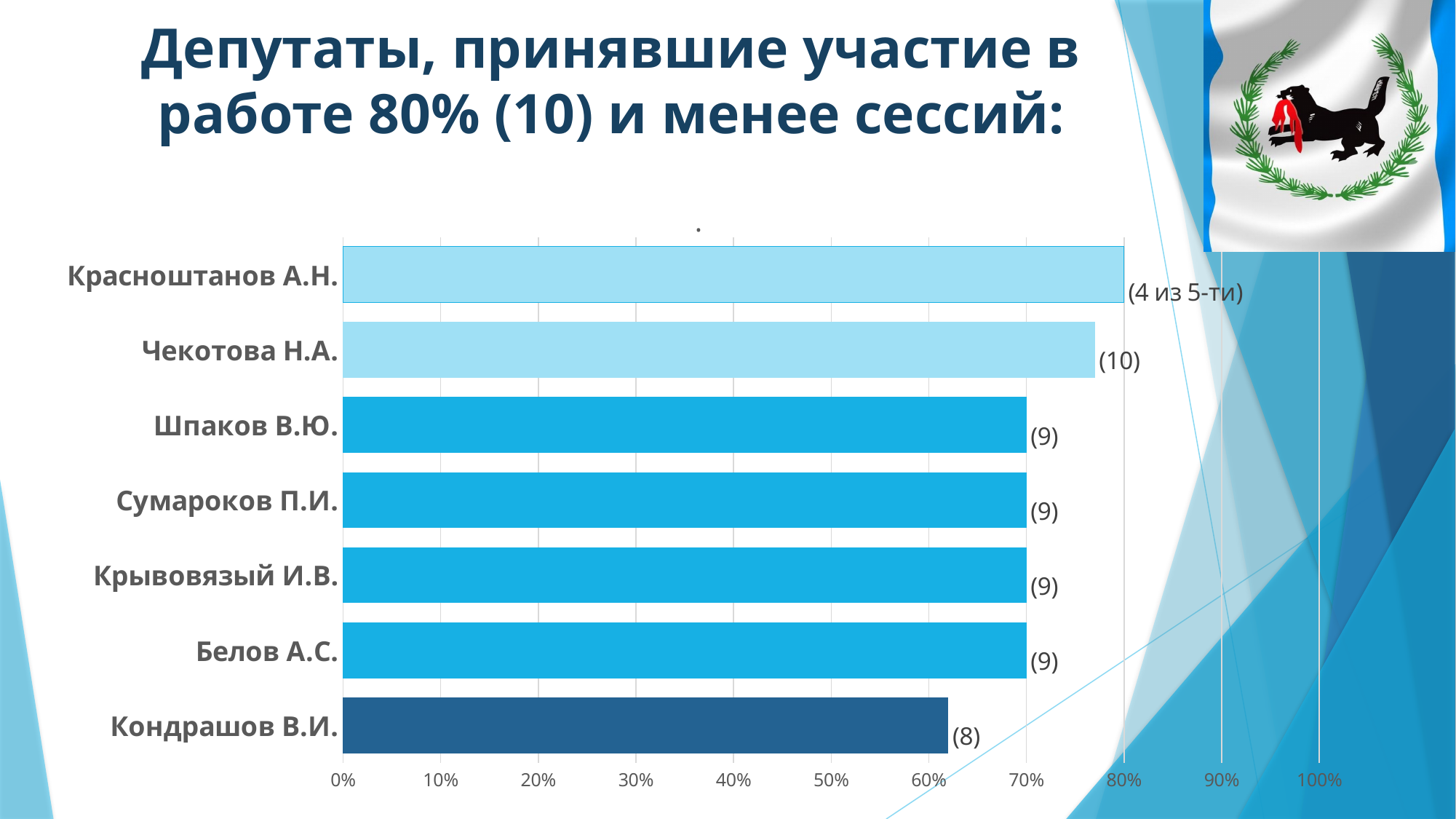
What data label is printed next to the bar for Чекотова Н.А.? (10) What data label is printed next to the bar for Красноштанов А.Н.? (4 из 5-ти) Is the value for Чекотова Н.А. greater or less than 70%? greater How many deputies (categories) are shown in the chart? 7 What kind of chart is shown on the slide? bar chart What data label is printed next to the bar for Кондрашов В.И.? (8) Is the value for Шпаков В.Ю. greater or less than 60%? greater Is the value for Кондрашов В.И. greater or less than 70%? less Which deputy has the longest bar in the chart? Красноштанов А.Н. Which bar is longer: Чекотова Н.А. or Белов А.С.? Чекотова Н.А. How many deputies have the data label (9)? 4 Which deputy has the shortest bar in the chart? Кондрашов В.И.